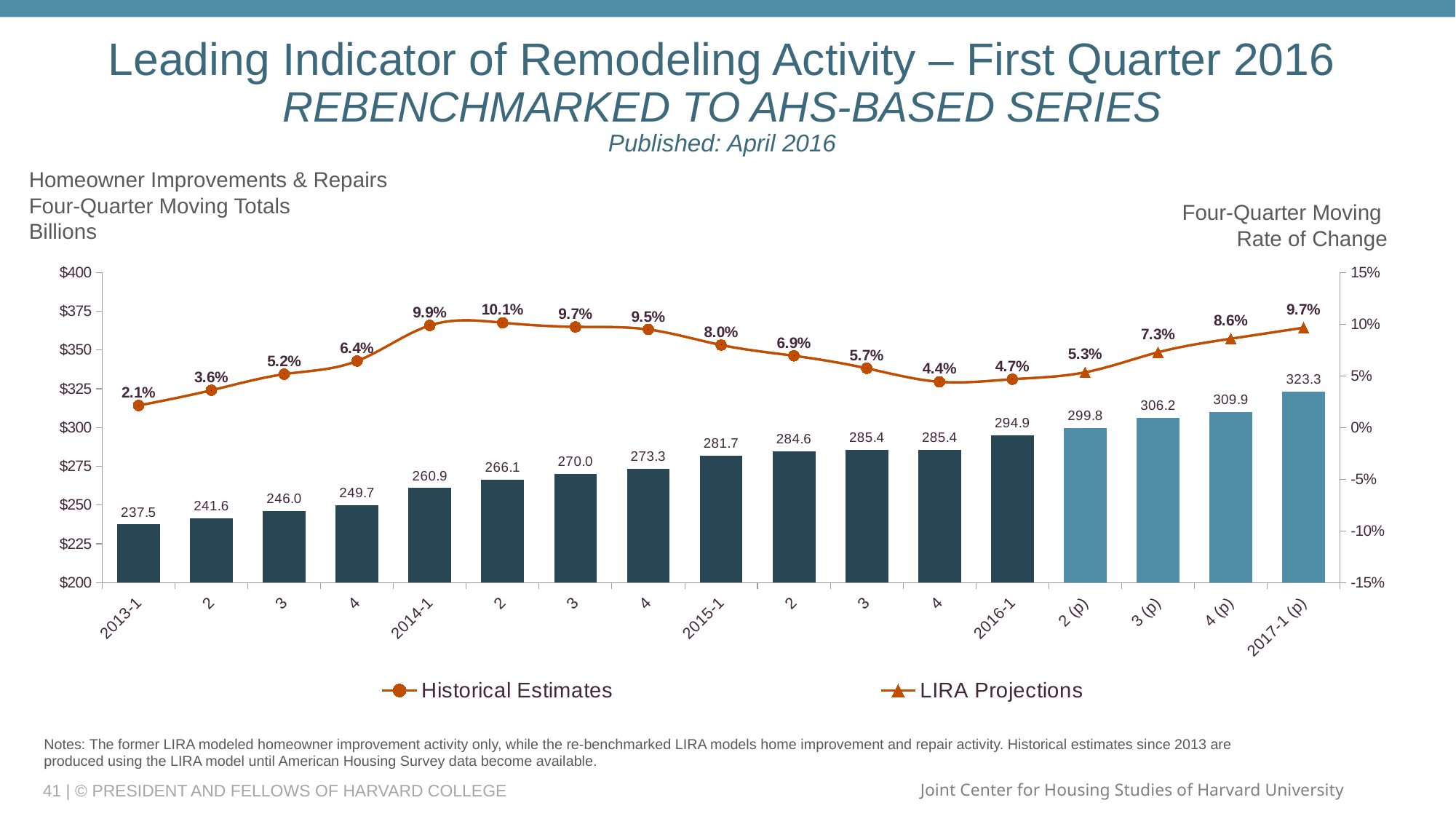
Do the four-quarter moving totals rise or fall from 2013-1 to 2017-1 (p)? rise What is the four-quarter moving rate of change for 2014-2? 10.1% What is the four-quarter moving total (billions) for 2016-1? 294.9 What is the difference between the four-quarter moving totals for 2017-1 (p) and 2016-1? 28.4 How many quarters are shown on the x axis? 17 What kind of chart is used to show the four-quarter moving totals? bar chart Which quarter has the lowest four-quarter moving total? 2013-1 Which quarter has the highest four-quarter moving rate of change? 2014-2 What are the two series named in the legend? Historical Estimates and LIRA Projections Which is larger, the rate of change for 2015-4 or for 2016-1? 2016-1 What is the projected four-quarter moving total for 2017-1 (p)? 323.3 How many series does the legend list? 2